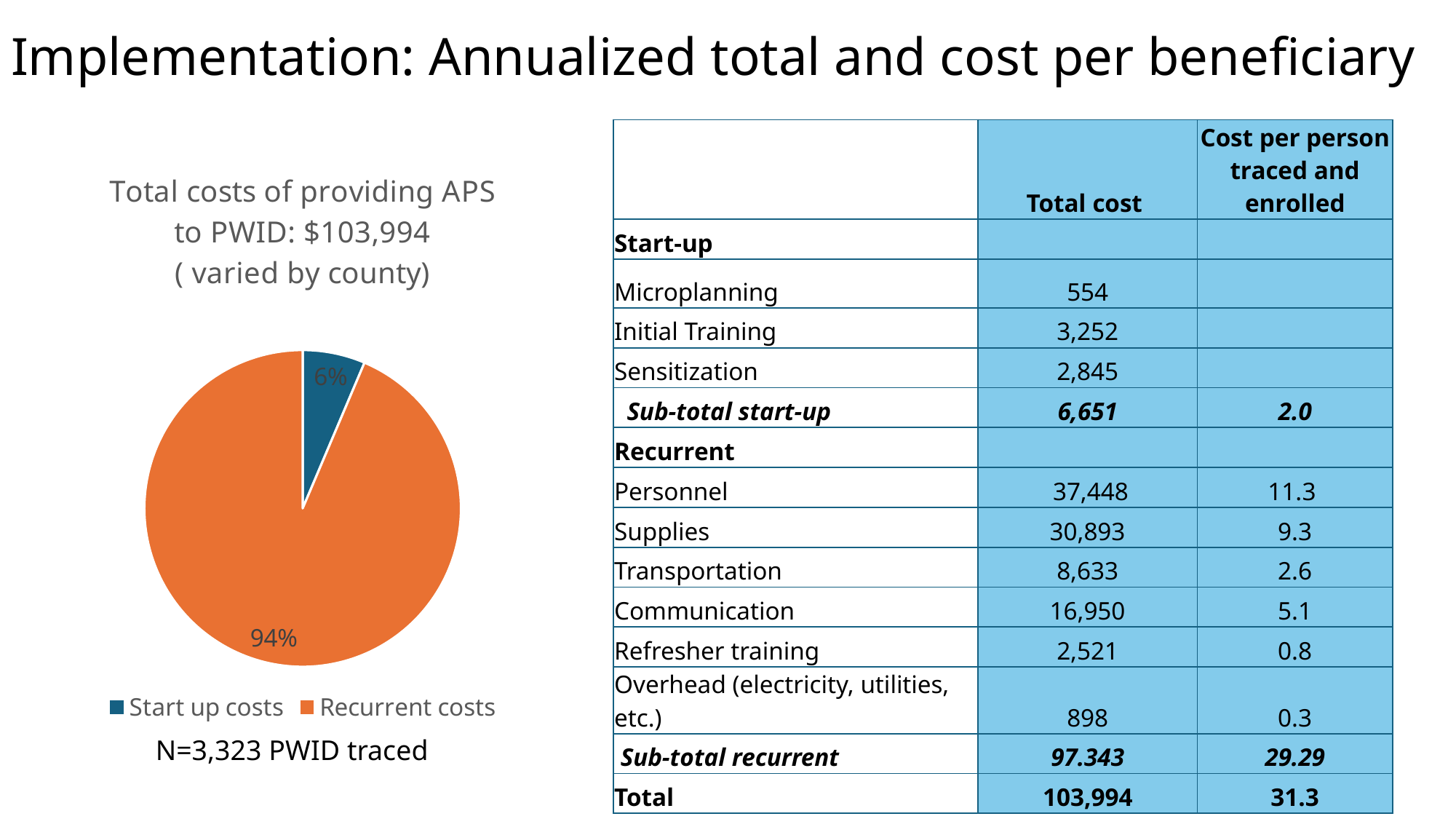
What total cost figure is given in the pie chart's title? $103,994 What type of chart is shown on the left of the slide? Pie chart What colour is the Start up costs slice in the pie chart? Blue Which is larger in the pie chart, Start up costs or Recurrent costs? Recurrent costs Which slice of the pie chart is the smallest? Start up costs How many entries does the pie chart's legend list? 2 Which slice of the pie chart is the largest? Recurrent costs How many slices does the pie chart have? 2 What is the difference in percentage points between the Recurrent costs slice and the Start up costs slice? 88 percentage points What share of the pie chart is Recurrent costs? 94% What share of the pie chart is Start up costs? 6%